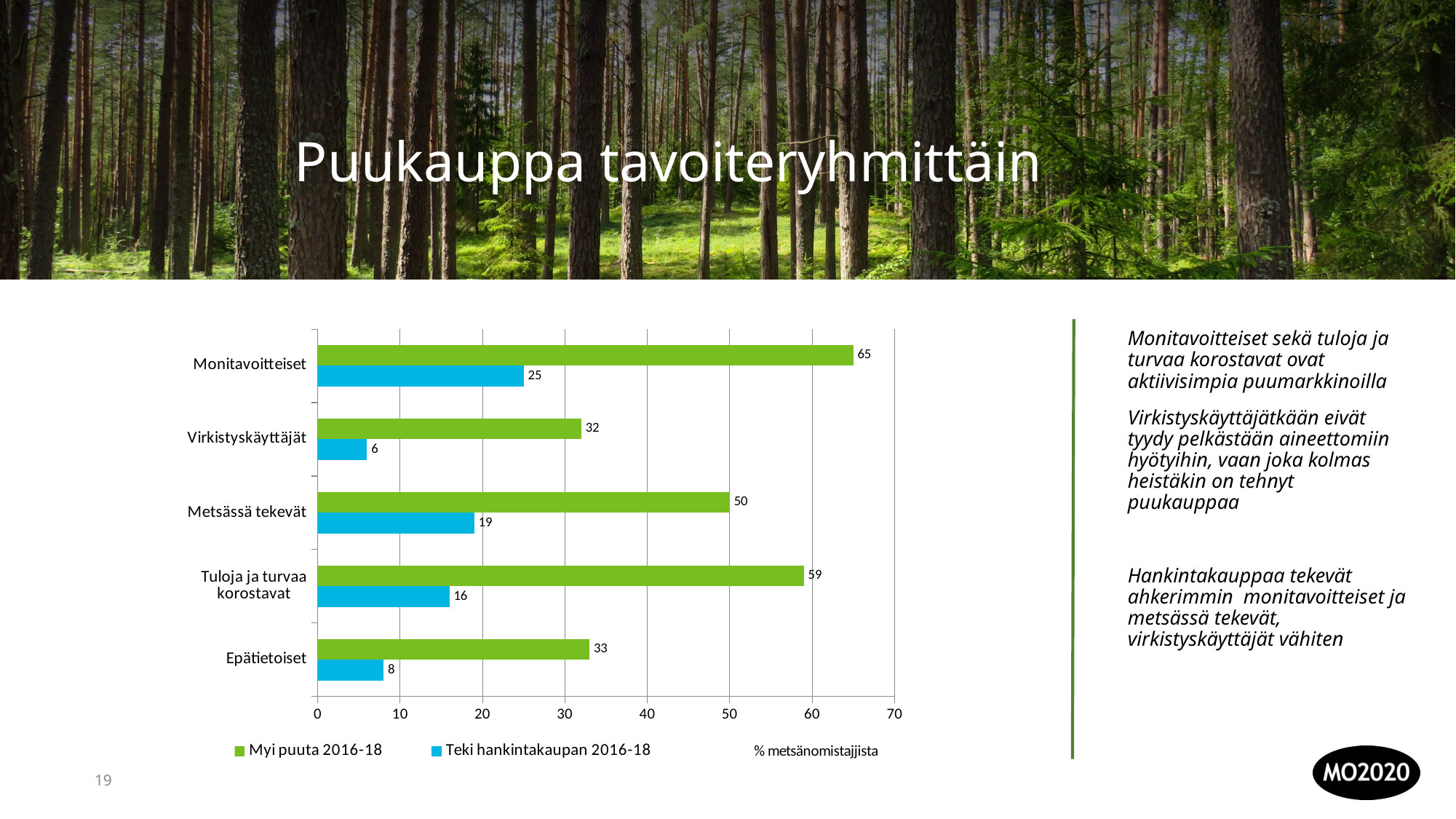
What is the value for Monitavoitteiset in the Myi puuta 2016-18 series? 65 What colour are the bars for the Teki hankintakaupan 2016-18 series? Blue What is the value for Tuloja ja turvaa korostavat in the Myi puuta 2016-18 series? 59 What kind of chart is shown on the slide? Bar chart Which category has the lowest value in the Teki hankintakaupan 2016-18 series? Virkistyskäyttäjät What is the value for Virkistyskäyttäjät in the Teki hankintakaupan 2016-18 series? 6 Is the Myi puuta 2016-18 value for Metsässä tekevät greater or less than 40? greater Which category has the highest value in the Myi puuta 2016-18 series? Monitavoitteiset How many categories are shown on the chart? 5 What is the difference between the Myi puuta 2016-18 and Teki hankintakaupan 2016-18 values for Metsässä tekevät? 31 Which is larger in the Myi puuta 2016-18 series: Epätietoiset or Virkistyskäyttäjät? Epätietoiset How many series does the legend list? 2